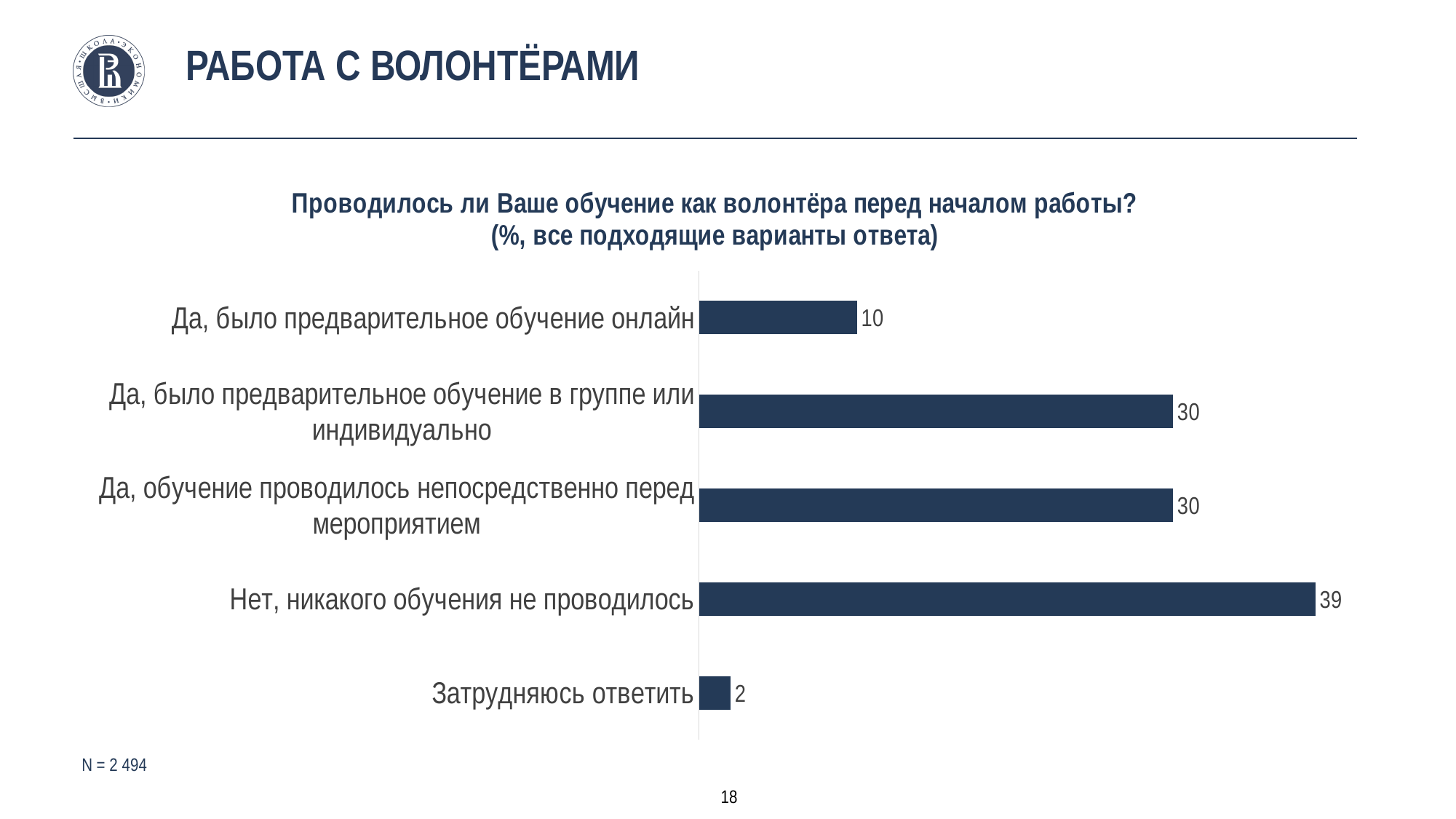
What is the value for "Да, было предварительное обучение онлайн"? 10 How many categories are shown in the chart? 5 What is the value for "Нет, никакого обучения не проводилось"? 39 Which category has the lowest value? Затрудняюсь ответить What is the value for "Затрудняюсь ответить"? 2 What is the sample size (N) stated on the slide? N = 2 494 What kind of chart is shown on the slide? Bar chart What is the difference between the values for "Да, обучение проводилось непосредственно перед мероприятием" and "Затрудняюсь ответить"? 28 What is the difference between the values for "Нет, никакого обучения не проводилось" and "Да, было предварительное обучение онлайн"? 29 Which category has the highest value? Нет, никакого обучения не проводилось What is the value for "Да, было предварительное обучение в группе или индивидуально"? 30 Which is larger: the value for "Да, было предварительное обучение онлайн" or the value for "Да, обучение проводилось непосредственно перед мероприятием"? Да, обучение проводилось непосредственно перед мероприятием